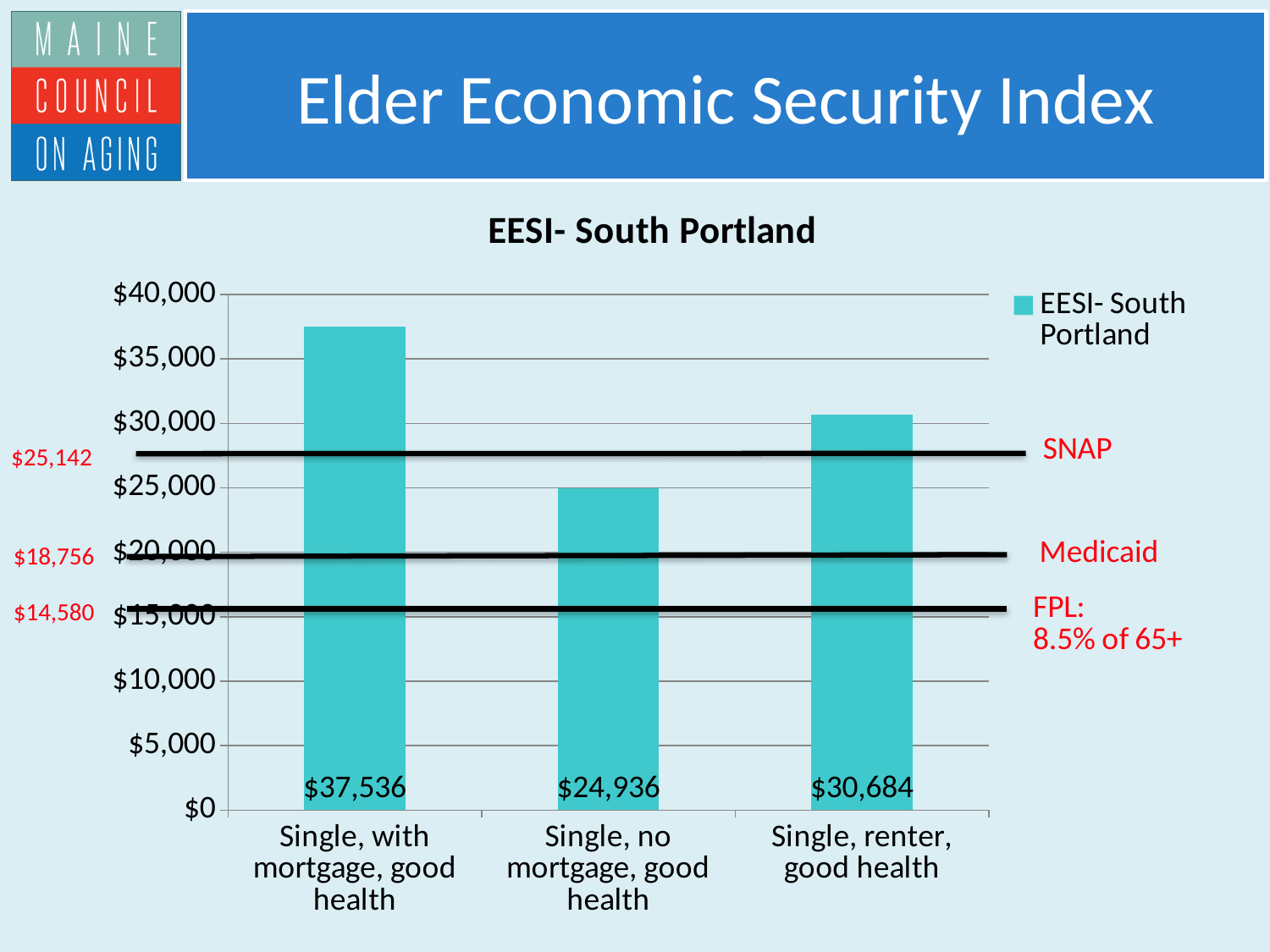
What is the value for "Single, with mortgage, good health"? $37,536 How many categories are shown on the x axis? 3 Which is larger, the value for "Single, renter, good health" or "Single, no mortgage, good health"? Single, renter, good health What is the value for "Single, renter, good health"? $30,684 What is the title of the chart? EESI- South Portland Which category has the lowest value? Single, no mortgage, good health What is the difference between the values for "Single, renter, good health" and "Single, no mortgage, good health"? $5,748 Is the value for "Single, no mortgage, good health" greater or less than $25,000? less Which category has the highest value? Single, with mortgage, good health What is the value for "Single, no mortgage, good health"? $24,936 What kind of chart is shown on the slide? bar chart What is the difference between the values for "Single, with mortgage, good health" and "Single, no mortgage, good health"? $12,600